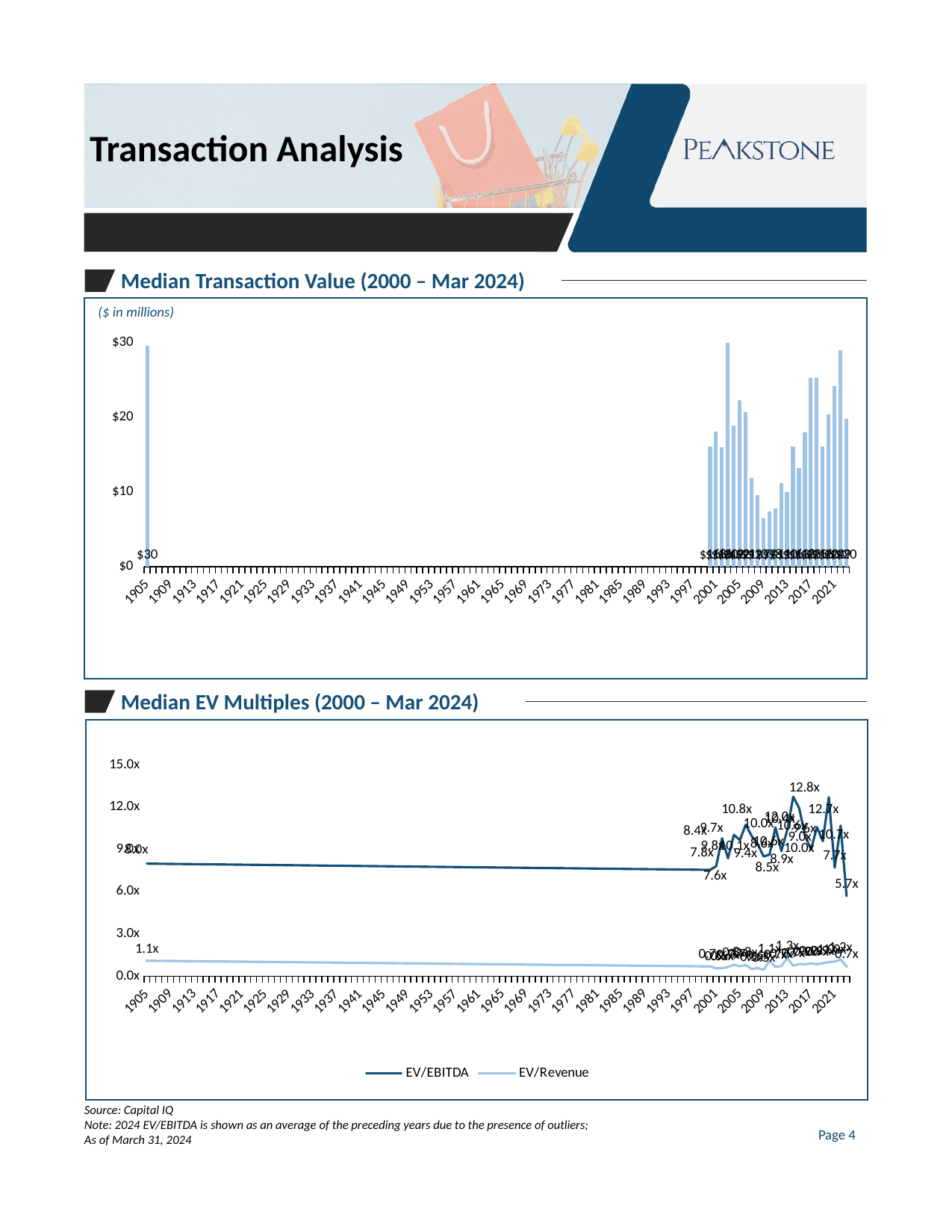
In the Median Transaction Value chart, what is the highest value shown on the vertical axis? $30 What kind of chart is the Median EV Multiples (2000 – Mar 2024) chart? line chart In the Median EV Multiples chart, which series has higher values throughout, EV/EBITDA or EV/Revenue? EV/EBITDA In the Median EV Multiples chart, is the final EV/EBITDA value greater or less than 6.0x? less What kind of chart is the Median Transaction Value (2000 – Mar 2024) chart? bar chart In the Median Transaction Value chart, what unit is stated for the values? $ in millions How many series does the legend of the Median EV Multiples chart list? 2 In the Median EV Multiples chart, what is the difference between the peak EV/EBITDA value of 12.8x and the final value of 5.7x? 7.1x In the Median Transaction Value chart, what is the labeled value of the first bar at 1905? $30 In the Median EV Multiples chart, what is the EV/EBITDA value labeled at the final point of the line? 5.7x In the Median EV Multiples chart, what is the EV/Revenue value labeled at the first point of the line? 1.1x In the Median EV Multiples chart, what is the highest labeled EV/EBITDA value? 12.8x